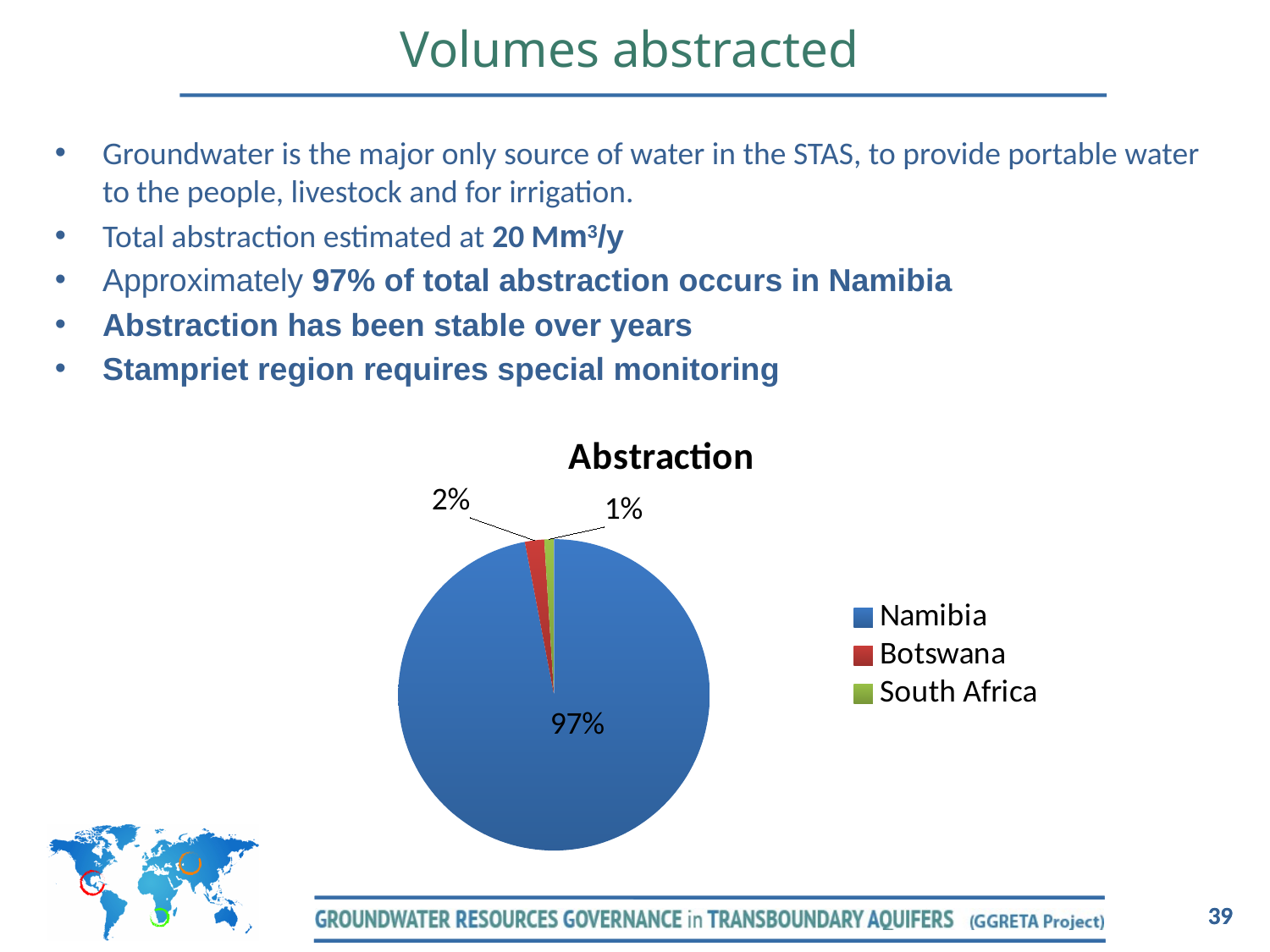
What colour is the slice for Namibia? blue Which country has the smallest slice in the pie chart? South Africa What share of abstraction does Botswana account for in the pie chart? 2% How many entries does the legend list? 3 What share of abstraction does South Africa account for in the pie chart? 1% Which country has the largest slice in the pie chart? Namibia How many categories does the pie chart show? 3 What is the title of the chart? Abstraction Which has a larger share of abstraction, Botswana or South Africa? Botswana What share of abstraction does Namibia account for in the pie chart? 97% What type of chart is shown on the slide? pie chart What is the difference in percentage points between Namibia's and Botswana's shares? 95